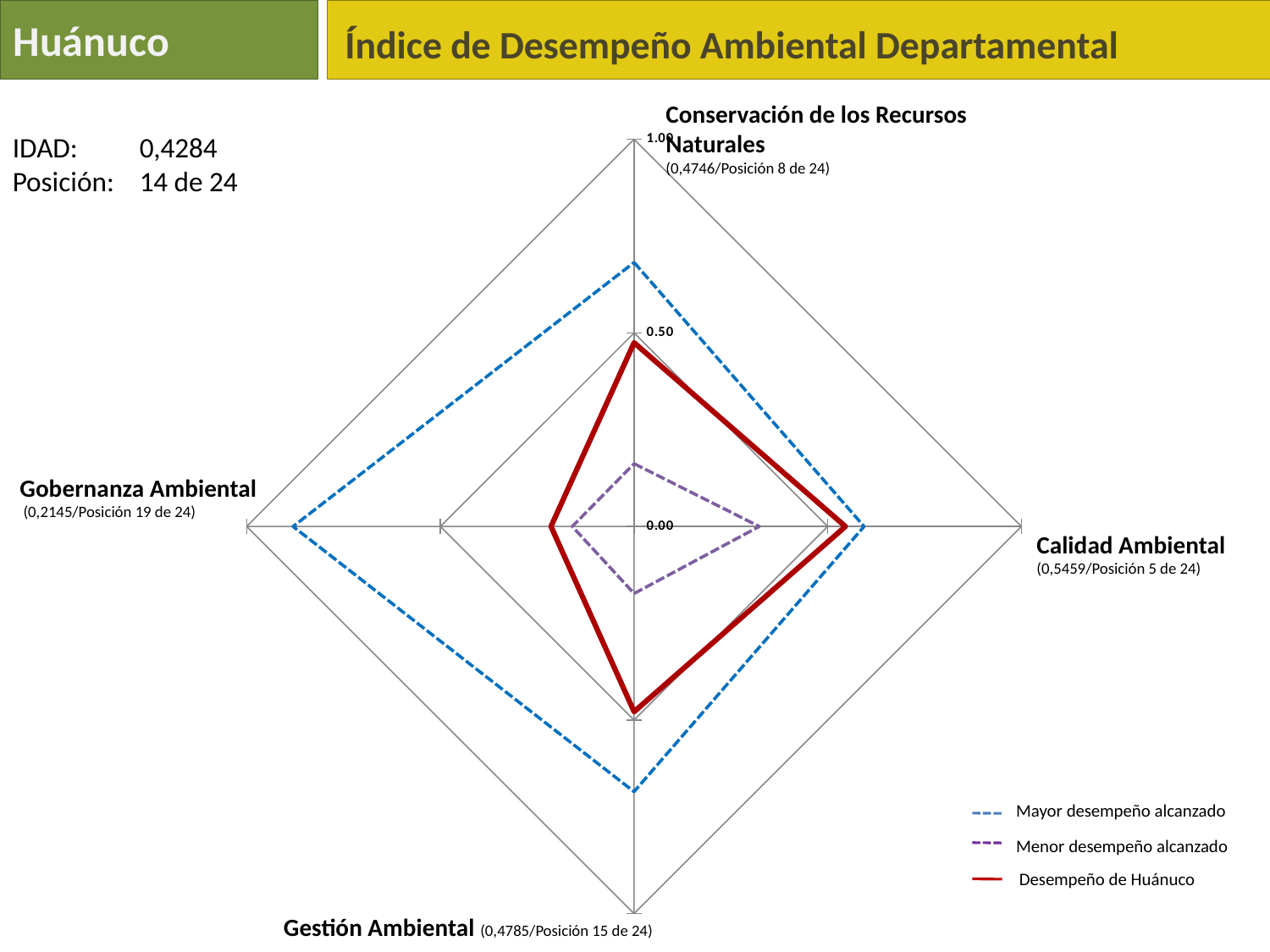
How many axes (categories) does the chart have? 4 On which axis does Huánuco score highest? Calidad Ambiental Is the Menor desempeño alcanzado value on the Calidad Ambiental axis greater or less than 0.50? less What is Huánuco's value for Gobernanza Ambiental? 0,2145 How many series does the legend list? 3 Which is larger for Huánuco: Gestión Ambiental or Conservación de los Recursos Naturales? Gestión Ambiental What is Huánuco's value for Calidad Ambiental? 0,5459 What is Huánuco's value for Gestión Ambiental? 0,4785 On which axis does Huánuco score lowest? Gobernanza Ambiental Is the Mayor desempeño alcanzado value on the Gobernanza Ambiental axis greater or less than 0.50? greater What is Huánuco's value for Conservación de los Recursos Naturales? 0,4746 What is the difference between Huánuco's Calidad Ambiental value and its Gobernanza Ambiental value? 0,3314